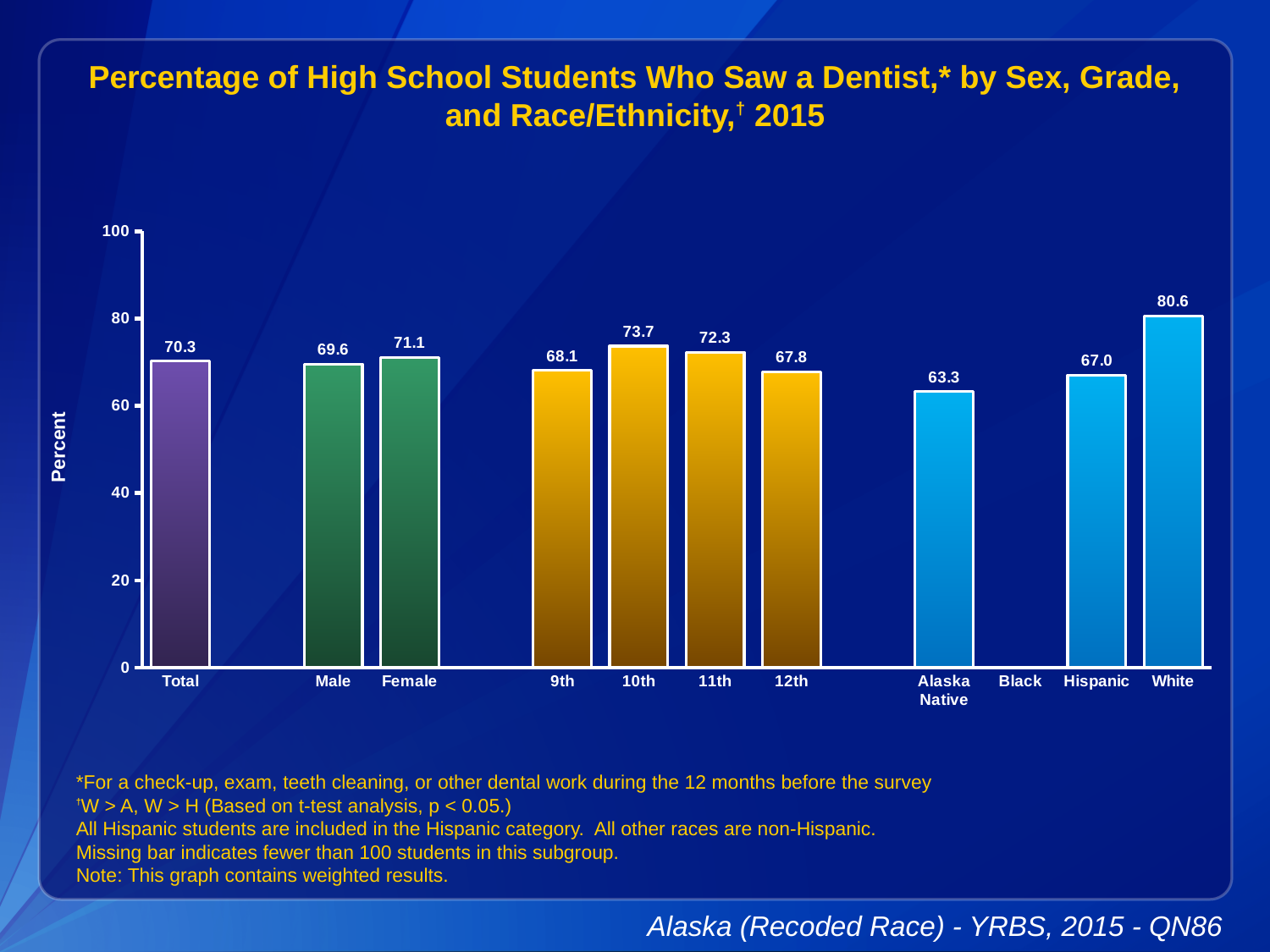
Which category label has no bar shown? Black What is the value for Alaska Native? 63.3 Is the value for White greater or less than 80? greater Which category has the lowest value? Alaska Native What is the difference between the values for Female and Male? 1.5 What is the value for 10th grade? 73.7 How many bars are plotted on the chart? 11 What is the value for Total? 70.3 Which is larger, the value for 10th grade or 12th grade? 10th What is the value for Female? 71.1 Which category has the highest value? White What kind of chart is shown? bar chart